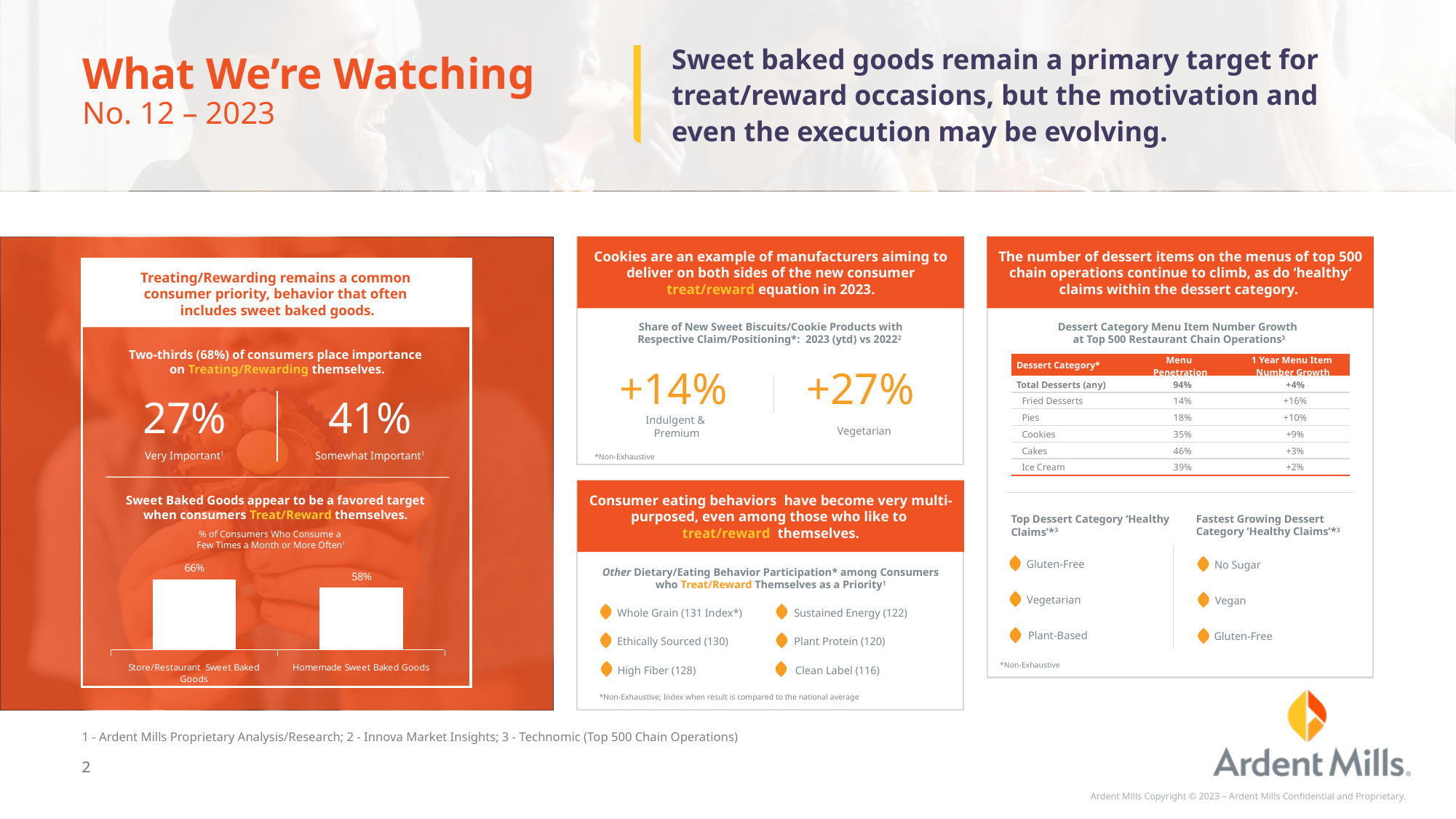
In the bar chart titled '% of Consumers Who Consume a Few Times a Month or More Often', what is the value for Store/Restaurant Sweet Baked Goods? 66% In the bar chart on the left panel, which category has the highest value? Store/Restaurant Sweet Baked Goods In the bar chart on the left panel, which is larger: the value for Store/Restaurant Sweet Baked Goods or the value for Homemade Sweet Baked Goods? Store/Restaurant Sweet Baked Goods In the bar chart on the left panel, do the values rise or fall from the left bar to the right bar? Fall In the bar chart titled '% of Consumers Who Consume a Few Times a Month or More Often', what is the value for Homemade Sweet Baked Goods? 58% What kind of chart is shown in the left panel under 'Sweet Baked Goods appear to be a favored target when consumers Treat/Reward themselves'? Bar chart What is the title of the bar chart on the left panel? % of Consumers Who Consume a Few Times a Month or More Often In the bar chart on the left panel, what is the difference between the values for Store/Restaurant Sweet Baked Goods and Homemade Sweet Baked Goods? 8% How many categories are shown in the bar chart on the left panel? 2 In the bar chart on the left panel, which category has the lowest value? Homemade Sweet Baked Goods